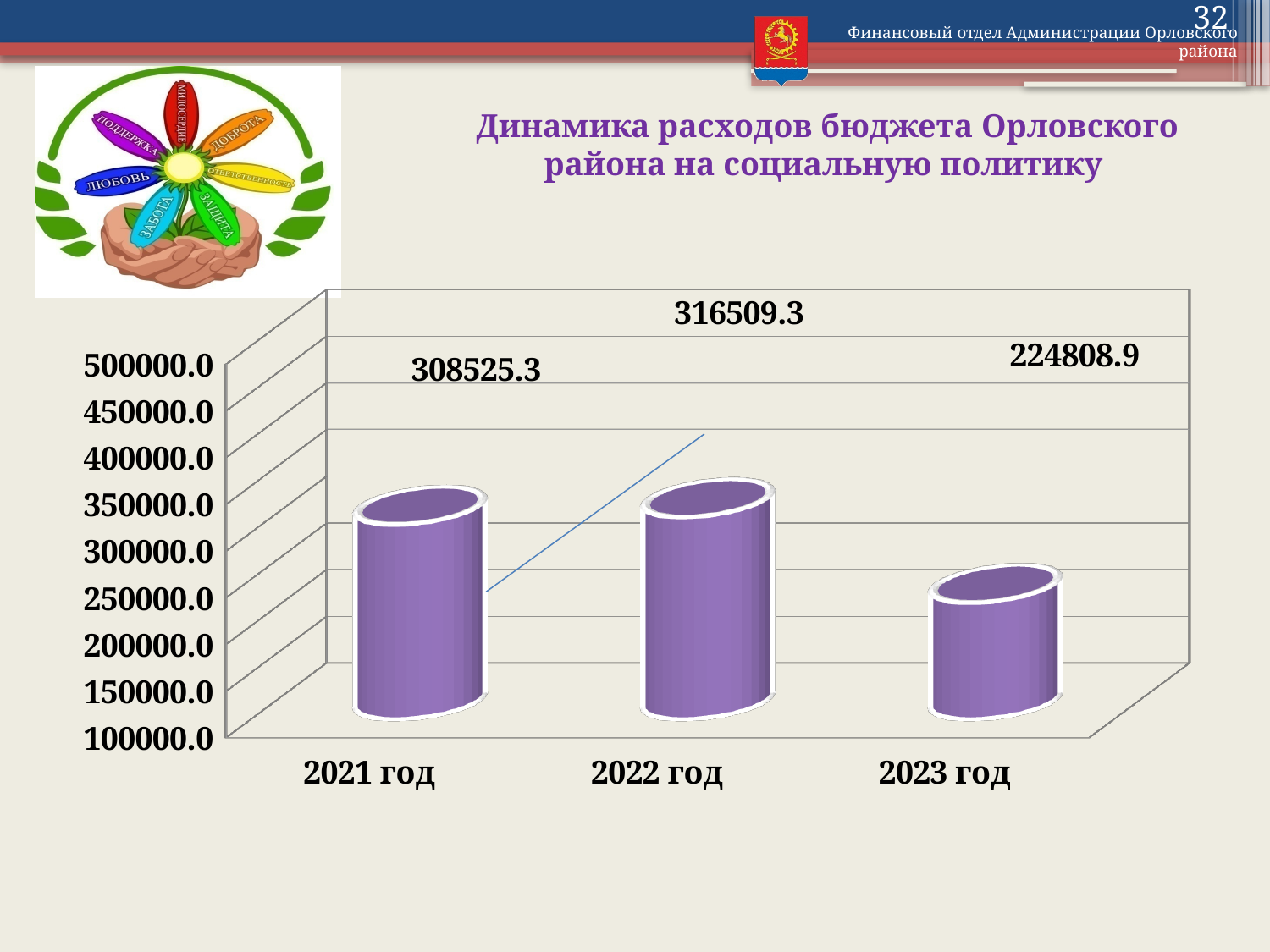
Which is larger, the value for 2021 год or the value for 2023 год? 2021 год What is the title of the chart? Динамика расходов бюджета Орловского района на социальную политику How many years are shown on the chart? 3 What is the difference between the values for 2022 год and 2021 год? 7984.0 What is the value for 2021 год? 308525.3 Is the value for 2023 год greater or less than 250000.0? less Which year has the lowest value? 2023 год Which year has the highest value? 2022 год What kind of chart is shown on the slide? bar chart What is the difference between the values for 2021 год and 2023 год? 83716.4 What is the value for 2023 год? 224808.9 What is the value for 2022 год? 316509.3